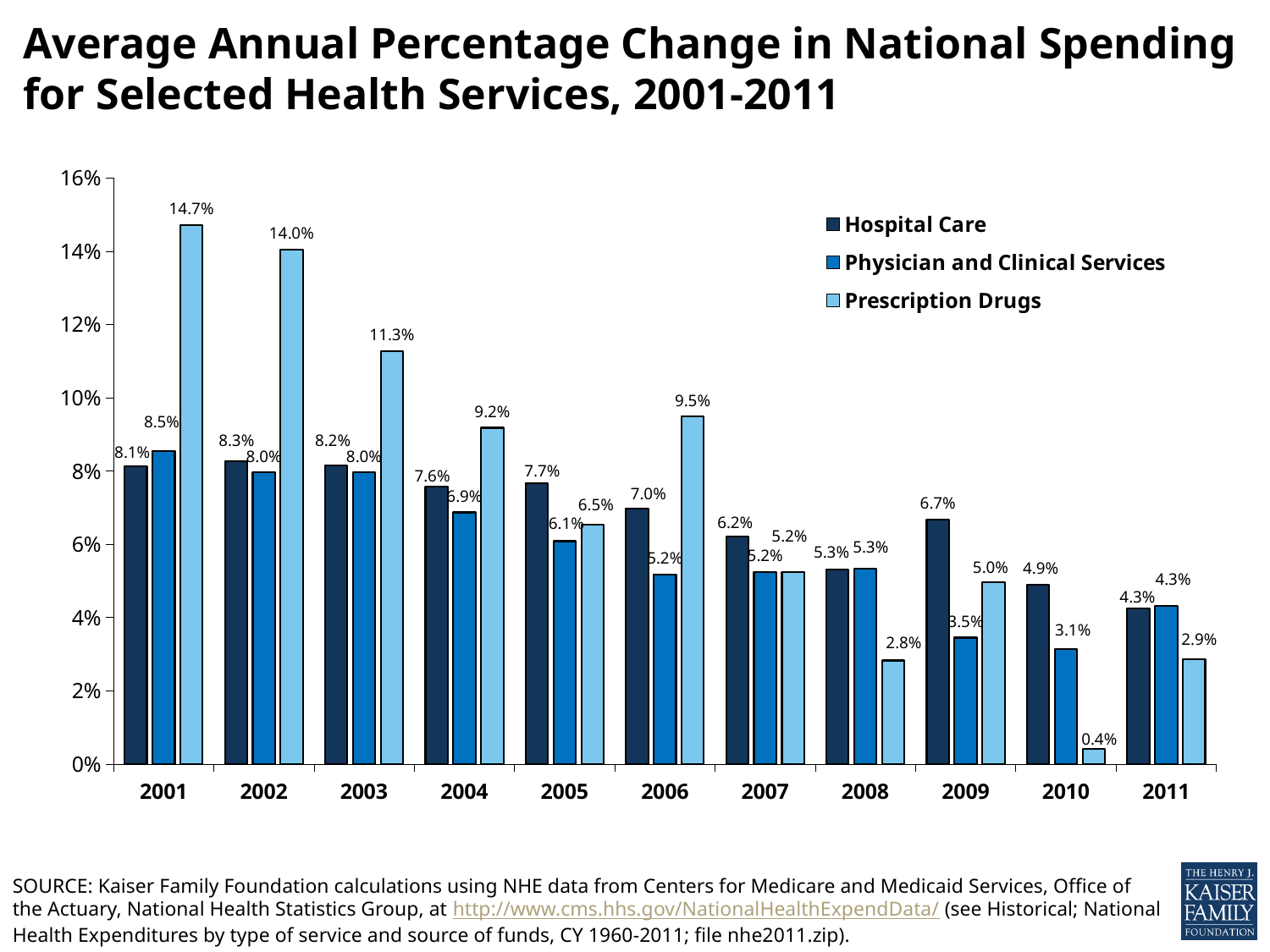
What was the value for Hospital Care in 2009? 6.7% In which year was the Prescription Drugs value the lowest? 2010 How many series does the legend list? 3 In which year was the Prescription Drugs value the highest? 2001 Which was larger in 2006, Hospital Care or Prescription Drugs? Prescription Drugs What is the difference between Hospital Care and Physician and Clinical Services in 2009? 3.2% How many years are shown on the x axis? 11 What was the average annual percentage change for Prescription Drugs in 2001? 14.7% Does the Hospital Care value generally rise or fall from 2001 to 2011? Fall What was the value for Physician and Clinical Services in 2004? 6.9% What kind of chart is shown on the slide? Bar chart What is the difference between the Prescription Drugs value in 2001 and in 2002? 0.7%